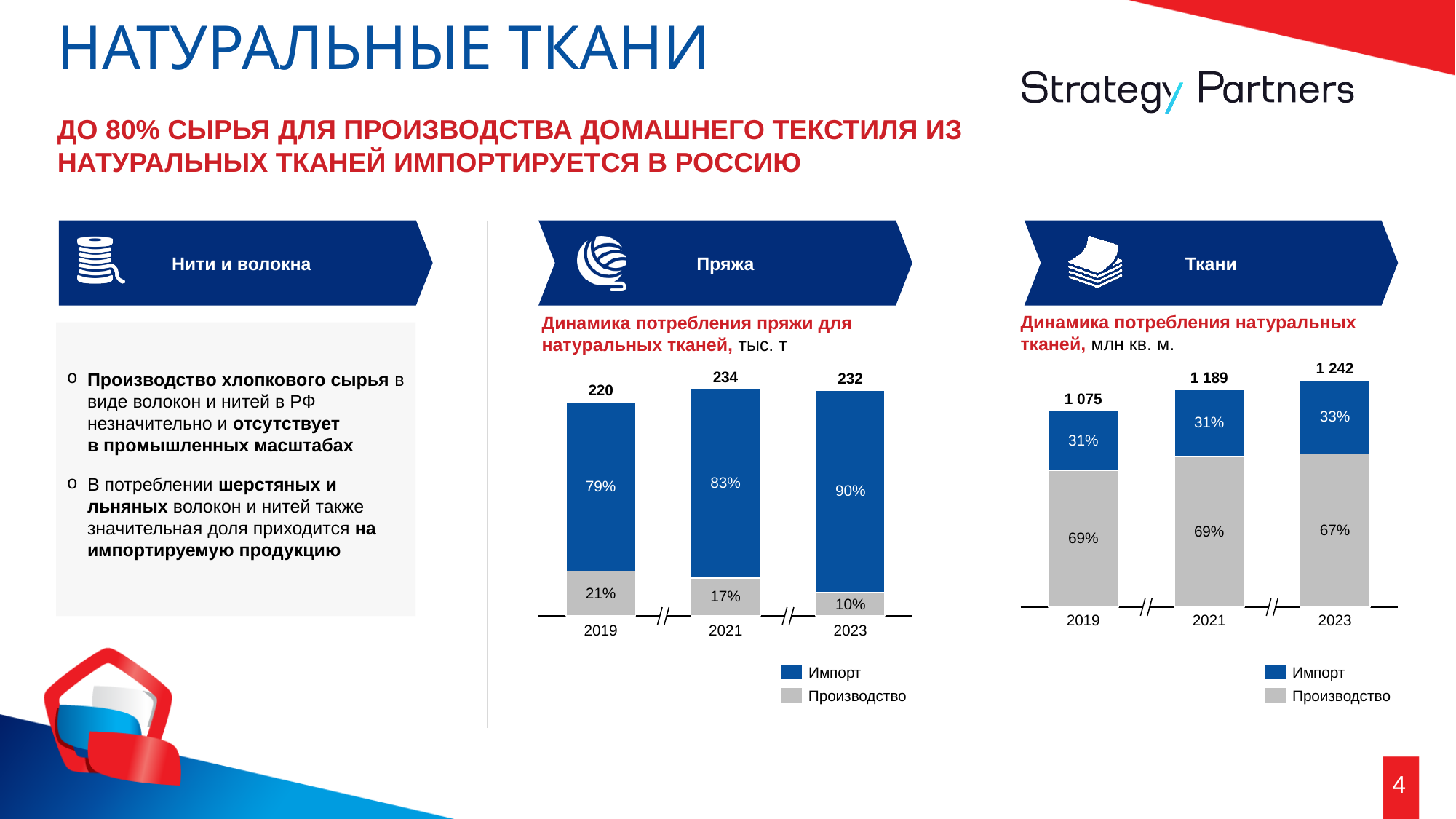
In the 'Динамика потребления пряжи для натуральных тканей' chart, which year has the highest total? 2021 In the 'Динамика потребления натуральных тканей' chart, what share does Производство have in 2023? 67% In the 'Динамика потребления натуральных тканей' chart, how many years are shown on the x axis? 3 In the 'Динамика потребления пряжи для натуральных тканей' chart, what is the total value shown above the 2021 bar? 234 In the 'Динамика потребления пряжи для натуральных тканей' chart, what is the difference between the 2021 total and the 2019 total? 14 In the 'Динамика потребления натуральных тканей' chart, what is the total value shown above the 2023 bar? 1 242 In the 'Динамика потребления пряжи для натуральных тканей' chart, what share does Производство have in 2019? 21% What type of chart is the 'Динамика потребления пряжи для натуральных тканей' chart? stacked bar chart How many series does the legend of the 'Динамика потребления натуральных тканей' chart list? 2 In the 'Динамика потребления пряжи для натуральных тканей' chart, what share does Импорт have in 2023? 90% In the 'Динамика потребления пряжи для натуральных тканей' chart, does the Импорт share rise or fall from 2019 to 2023? rise In the 'Динамика потребления натуральных тканей' chart, which year has the lowest total? 2019